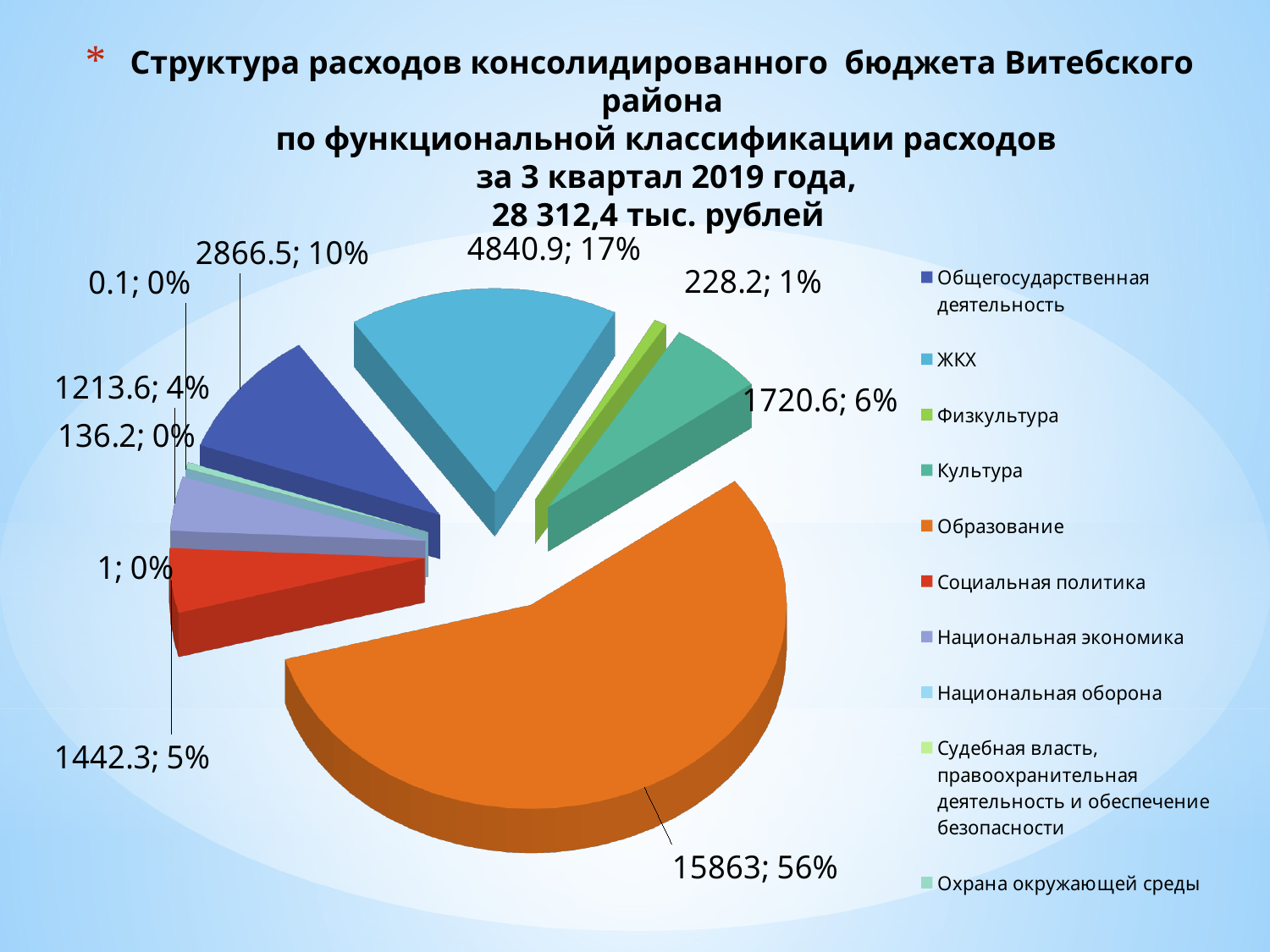
What share of the pie does Образование take? 56% What kind of chart is shown on the slide? pie chart How many categories does the legend of the pie chart list? 10 What value is shown for Национальная экономика? 1213.6 What value is shown for ЖКХ? 4840.9 Which category has the smallest value in the pie chart? Судебная власть, правоохранительная деятельность и обеспечение безопасности Which is larger, the value for Культура or the value for Социальная политика? Культура What is the difference between the values for ЖКХ and Общегосударственная деятельность? 1974.4 What total amount is stated in the chart title? 28 312,4 тыс. рублей What share of the pie does Общегосударственная деятельность take? 10% What value is shown for Образование? 15863 Which category has the largest slice of the pie? Образование